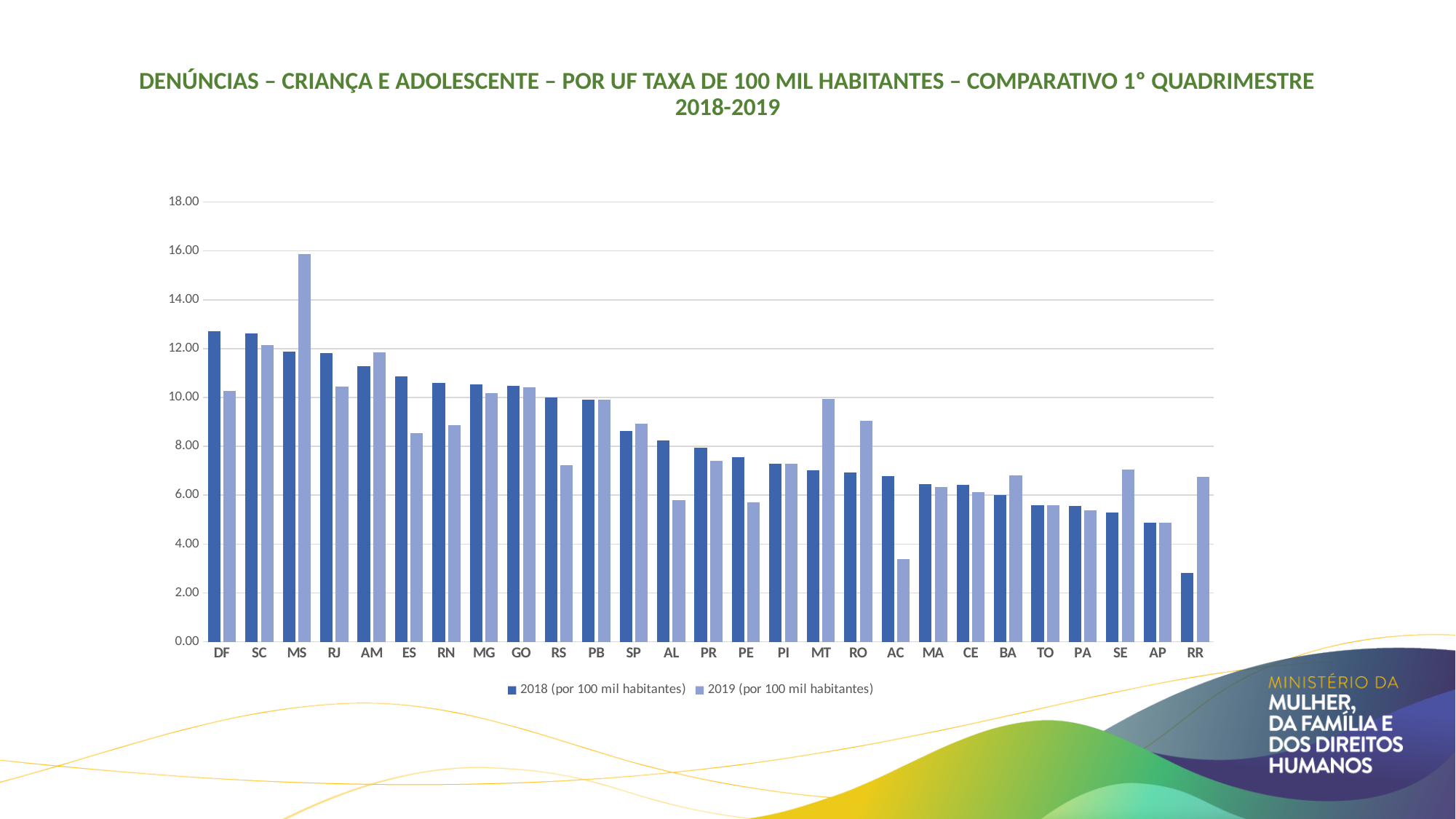
For DF, which series has the larger value, 2018 or 2019? 2018 Is the 2018 value for RR greater or less than 4.00? less Is the 2019 value for MS greater or less than 14.00? greater What kind of chart is shown on the slide? bar chart Do the 2018 (por 100 mil habitantes) values generally rise or fall from left to right along the x axis? fall How many series does the legend list? 2 How many UF categories are shown on the x axis? 27 Which UF has the lowest value for the 2019 (por 100 mil habitantes) series? AC For RR, which series has the larger value, 2018 or 2019? 2019 Which UF has the lowest value for the 2018 (por 100 mil habitantes) series? RR Which UF has the highest value for the 2019 (por 100 mil habitantes) series? MS Is the 2019 value for MT greater or less than 8.00? greater